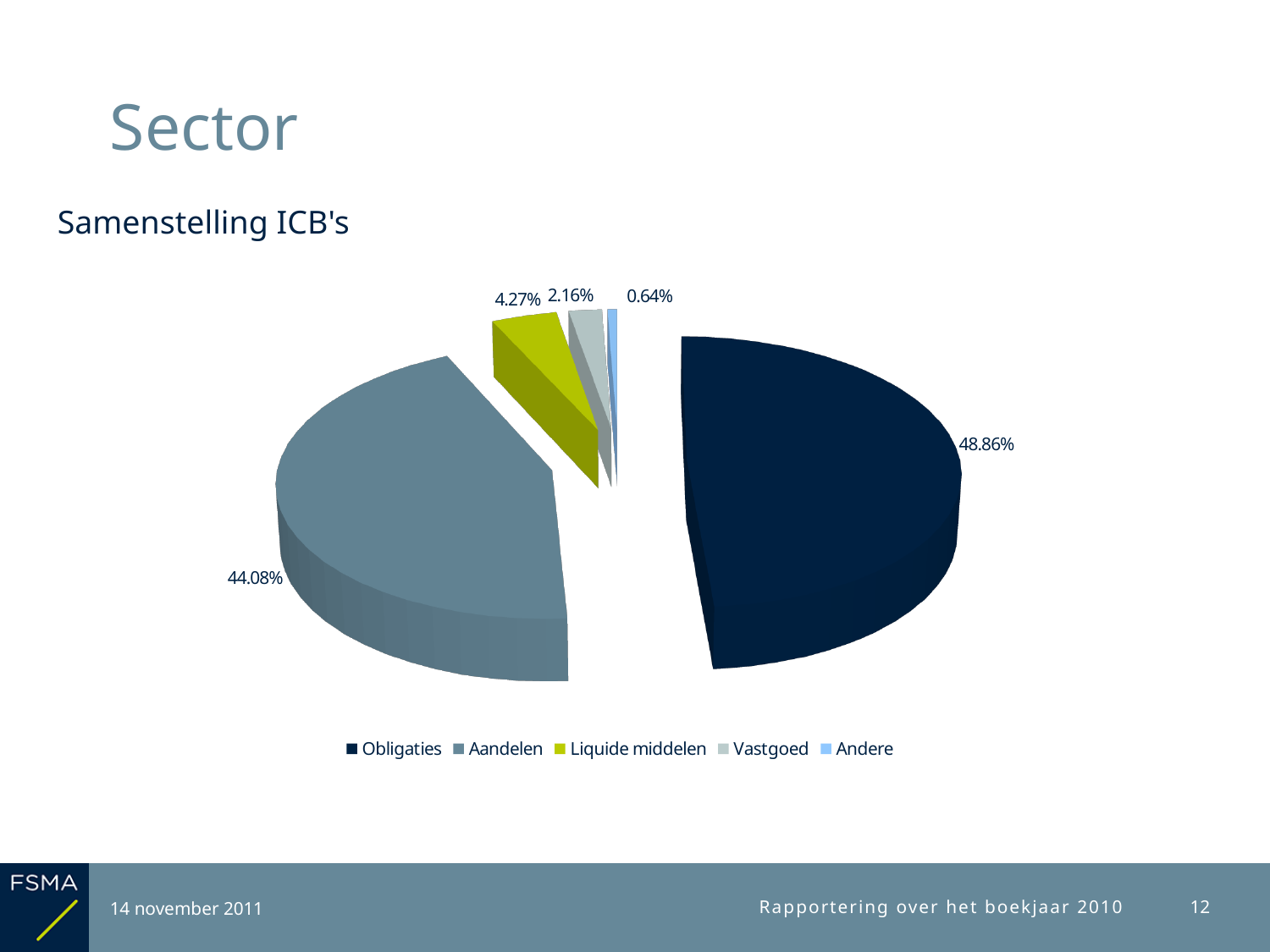
What kind of chart is shown on the slide? pie chart Which is larger, the share for Liquide middelen or the share for Vastgoed? Liquide middelen What is the difference in percentage points between Obligaties and Aandelen? 4.78 What share of the pie does Andere have? 0.64% What is the title shown above the chart? Samenstelling ICB's What share of the pie does Obligaties have? 48.86% How many categories does the legend list? 5 What share of the pie does Liquide middelen have? 4.27% What share of the pie does Vastgoed have? 2.16% Which category has the smallest slice of the pie? Andere What share of the pie does Aandelen have? 44.08% Which category has the largest slice of the pie? Obligaties